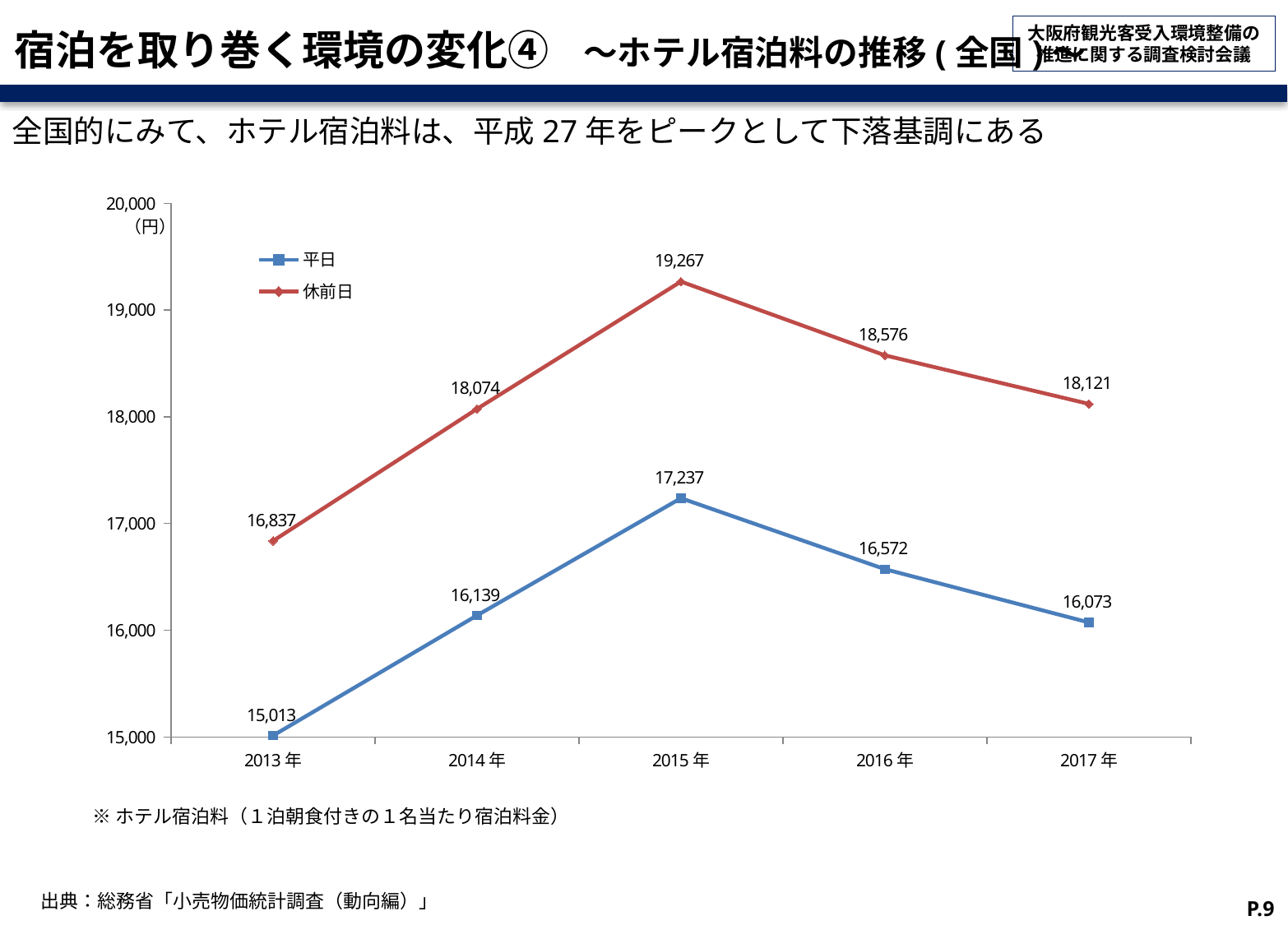
How many years are shown on the x axis? 5 What is the difference between the 平日 values in 2016年 and 2017年? 499 What is the value for 休前日 in 2017年? 18,121 What is the value for 平日 in 2013年? 15,013 In which year is the 平日 value lowest? 2013年 Which is larger, the 休前日 value in 2014年 or the 休前日 value in 2017年? 2017年 What is the value for 平日 in 2015年? 17,237 What is the difference between the 休前日 and 平日 values in 2015年? 2,030 What kind of chart is shown on the slide? line chart Is the 平日 value in 2014年 greater or less than 16,000? greater In which year is the 休前日 value highest? 2015年 How many series does the legend list? 2